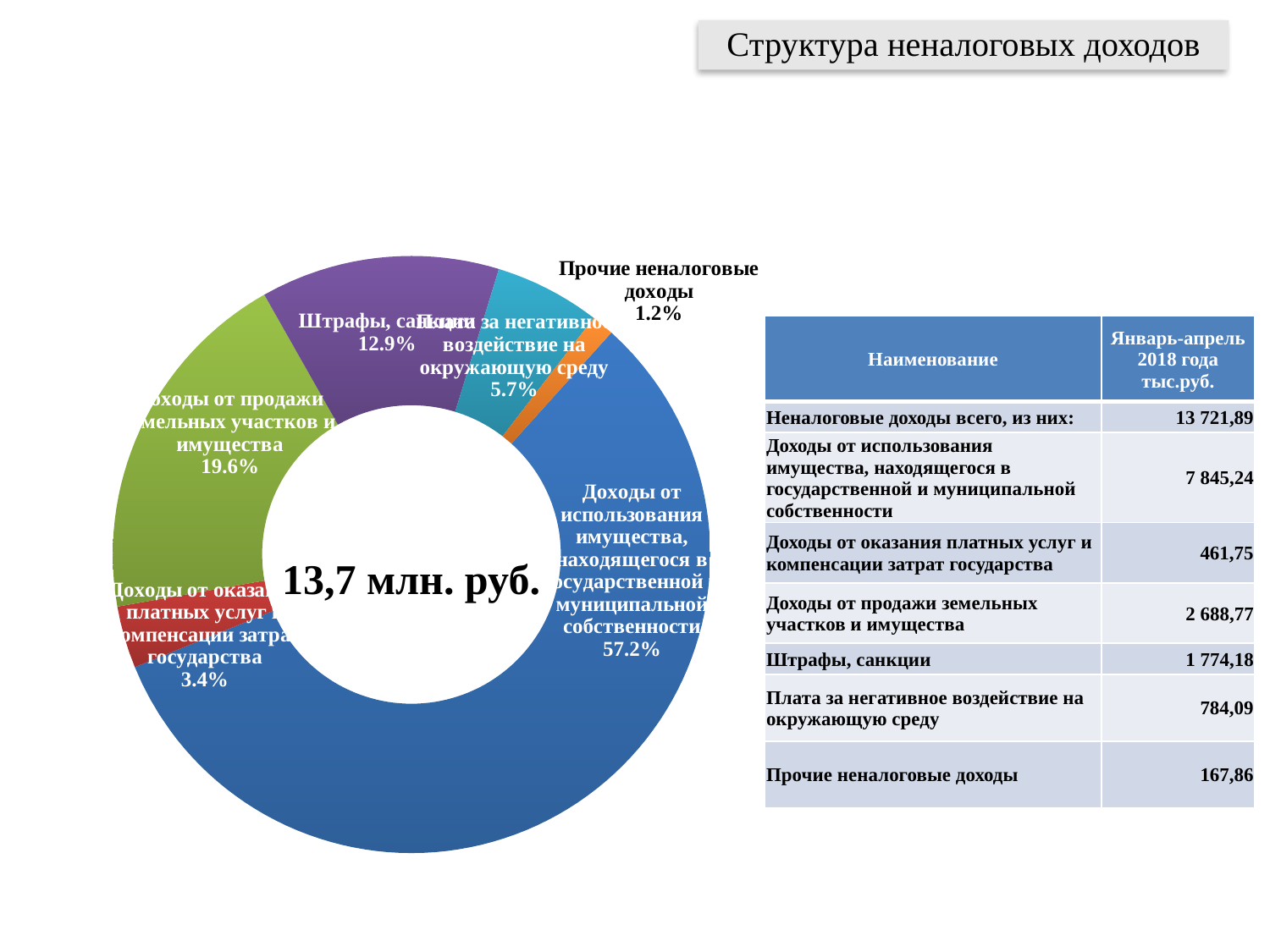
What percentage is shown for "Прочие неналоговые доходы"? 1.2% By how many percentage points does the share of "Доходы от использования имущества" (57.2%) exceed the share of "Доходы от продажи земельных участков и имущества" (19.6%)? 37.6 percentage points What is the title shown at the top of the slide? Структура неналоговых доходов What total value is printed in the centre of the doughnut chart? 13,7 млн. руб. What kind of chart is shown on the slide? Doughnut (pie) chart Which category has the smallest slice of the chart? Прочие неналоговые доходы (1.2%) Which slice is larger: "Штрафы, санкции" or "Плата за негативное воздействие на окружающую среду"? Штрафы, санкции What share of the chart is labelled for "Штрафы, санкции"? 12.9% Which category has the largest slice of the chart? Доходы от использования имущества, находящегося в государственной и муниципальной собственности (57.2%) How many slices does the chart have? 6 What percentage is shown for "Доходы от продажи земельных участков и имущества"? 19.6% What percentage is shown for "Плата за негативное воздействие на окружающую среду"? 5.7%